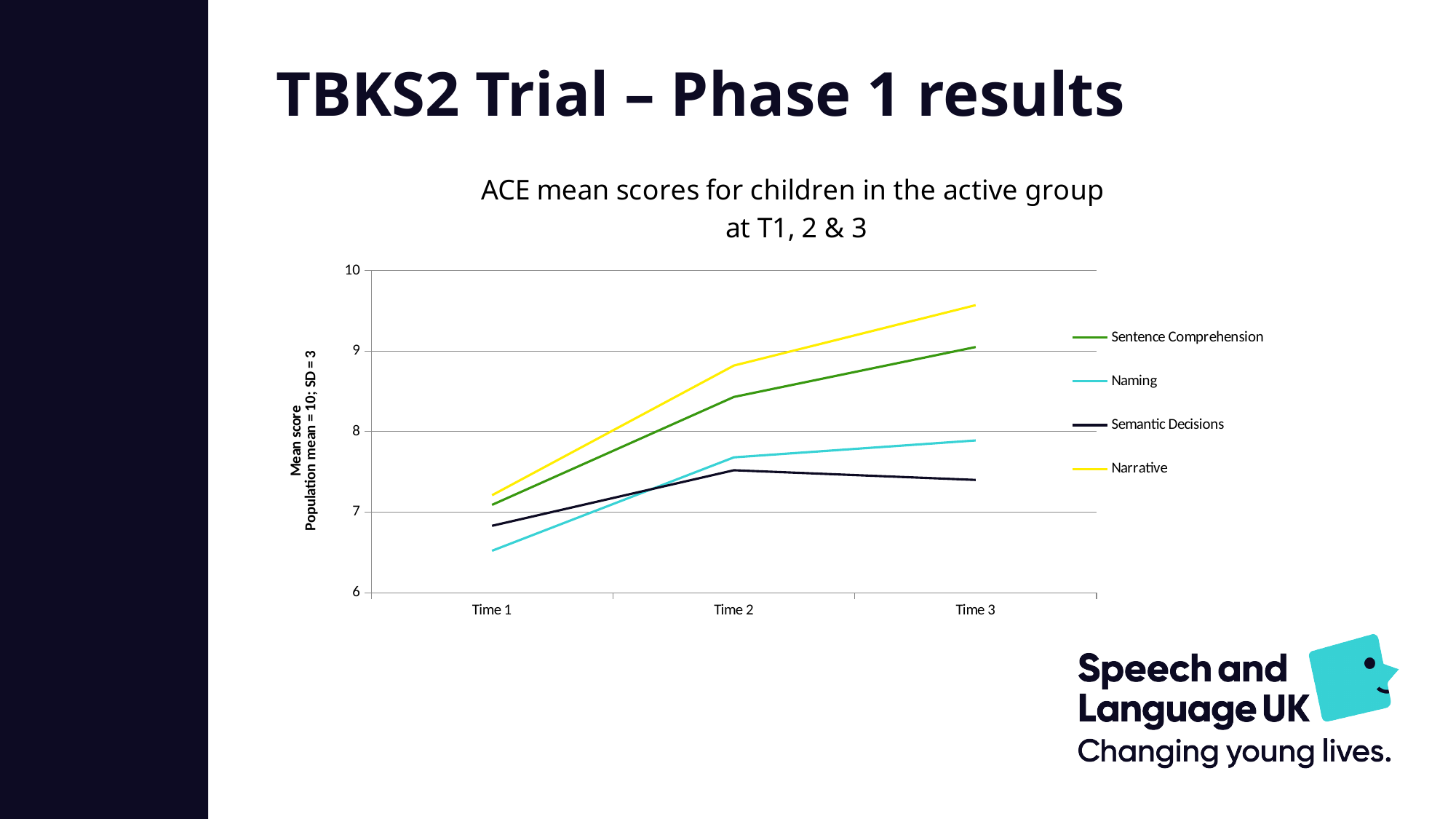
Is the value for Semantic Decisions at Time 3 greater or less than 8? less Is the value for Narrative at Time 3 greater or less than 9? greater Is the value for Naming at Time 1 greater or less than 7? less What is the title of the chart? ACE mean scores for children in the active group at T1, 2 & 3 At Time 2, which is higher: Narrative or Naming? Narrative Which series has the lowest mean score at Time 3? Semantic Decisions How many series does the legend list? 4 Which series has the highest mean score at Time 3? Narrative What kind of chart is shown on the slide? Line chart How many time points are plotted on the x axis? 3 Which series has the lowest mean score at Time 1? Naming Does the Semantic Decisions line rise or fall from Time 2 to Time 3? Fall